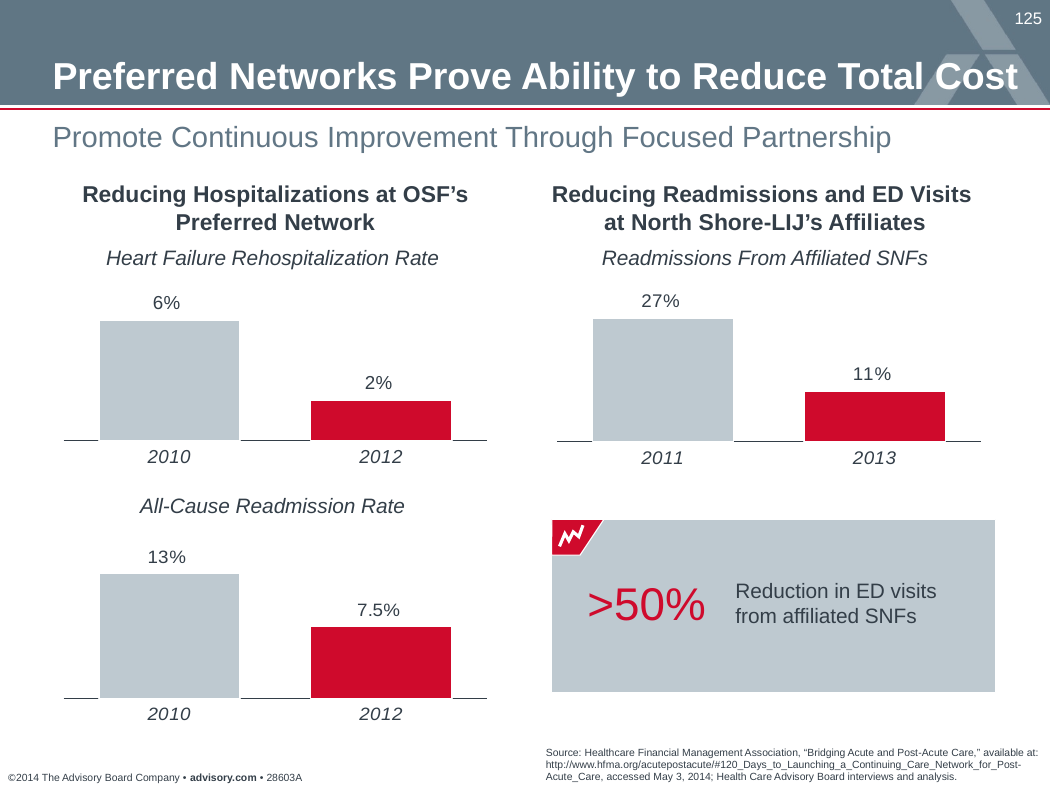
In the All-Cause Readmission Rate chart, what is the value for 2012? 7.5% What kind of chart is the Heart Failure Rehospitalization Rate chart? Bar chart In the Readmissions From Affiliated SNFs chart, what is the value for 2013? 11% In the Readmissions From Affiliated SNFs chart, what is the difference between the 2011 and 2013 values? 16% In the Heart Failure Rehospitalization Rate chart, what is the value for 2012? 2% In the Readmissions From Affiliated SNFs chart, what is the value for 2011? 27% In the Heart Failure Rehospitalization Rate chart, what is the value for 2010? 6% In the Readmissions From Affiliated SNFs chart, which year has the lowest value? 2013 In the Heart Failure Rehospitalization Rate chart, what is the difference between the 2010 and 2012 values? 4% In the All-Cause Readmission Rate chart, which is larger, the value for 2010 or the value for 2012? 2010 How many bars are shown in the Readmissions From Affiliated SNFs chart? 2 In the All-Cause Readmission Rate chart, which year has the highest value? 2010